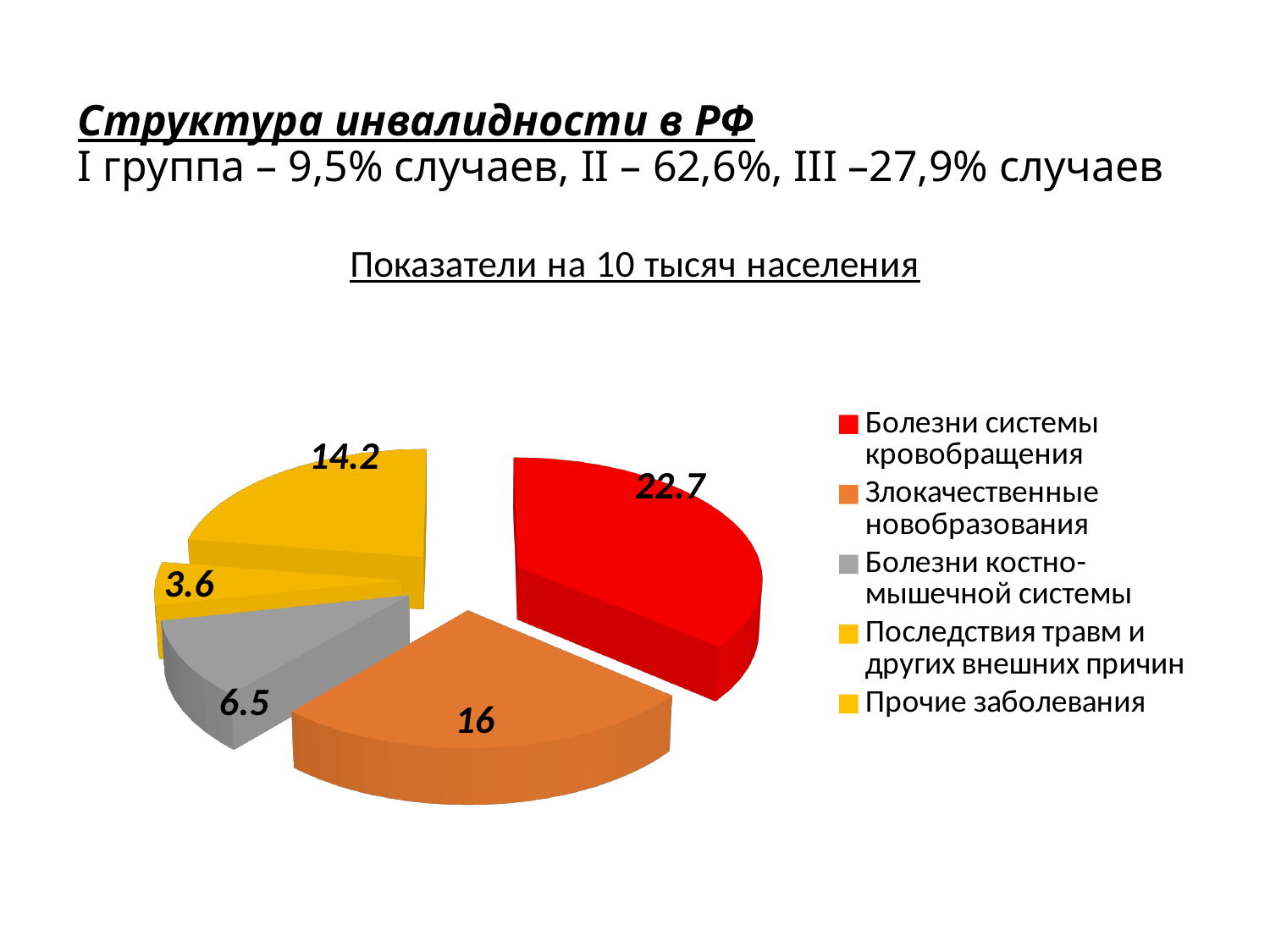
What type of chart is shown on the slide? Pie chart Which category has the highest value in the pie chart? Болезни системы кровообращения What is the total of all the values shown in the pie chart? 63 Which is larger: the value for Прочие заболевания or the value for Болезни костно-мышечной системы? Прочие заболевания What is the difference between the values for Болезни системы кровообращения and Злокачественные новообразования? 6.7 What is the value for Злокачественные новообразования? 16 How many slices does the pie chart have? 5 What is the value for Прочие заболевания? 14.2 What is the value for Болезни системы кровообращения? 22.7 What is the value for Болезни костно-мышечной системы? 6.5 What colour is the slice for Болезни системы кровообращения? Red Which category has the lowest value in the pie chart? Последствия травм и других внешних причин